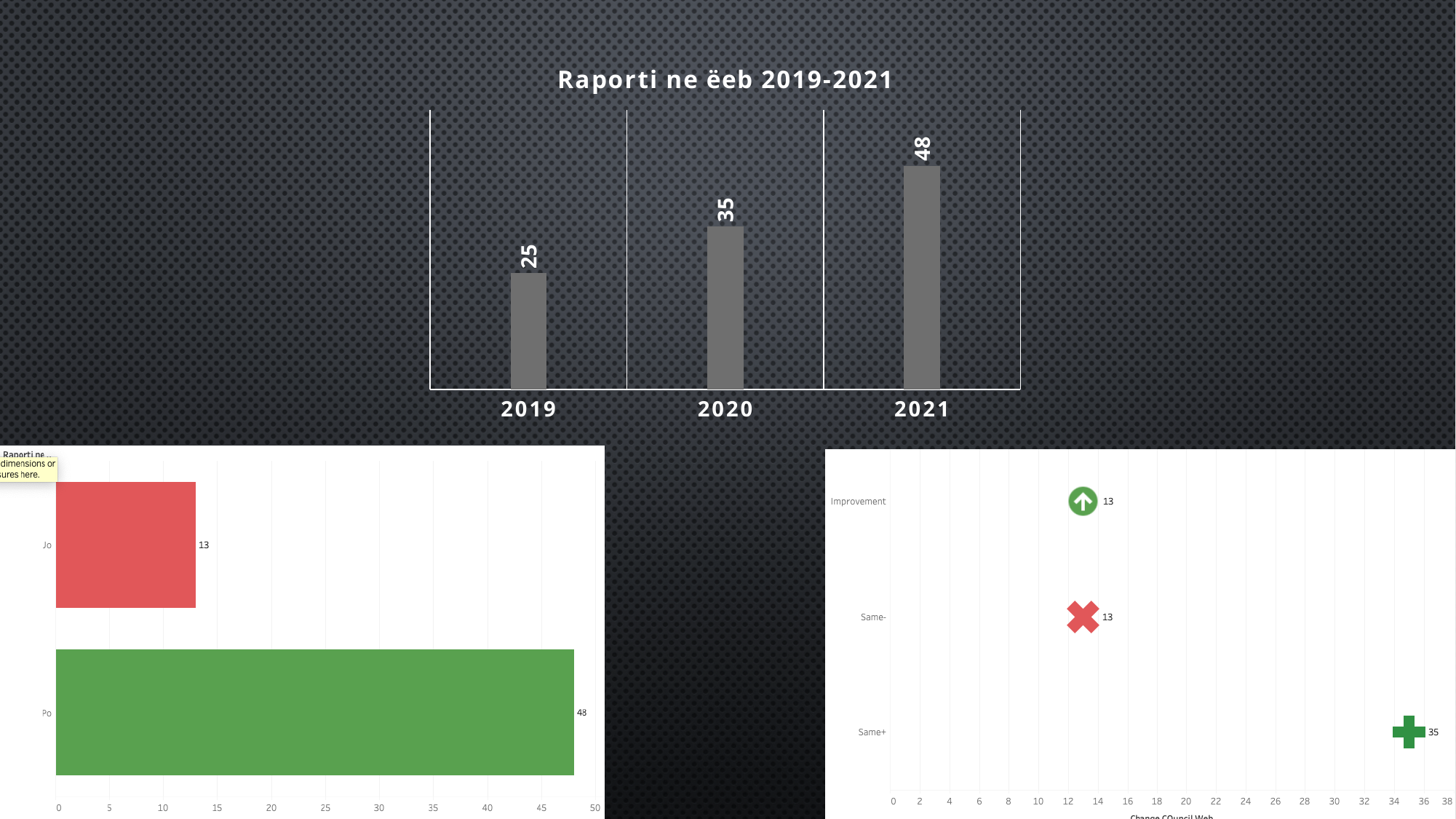
In the bottom-left chart, which is larger, Jo or Po? Po In the bottom-right chart, what is the value for Same+? 35 In the top chart titled "Raporti ne ëeb 2019-2021", do the values rise or fall from 2019 to 2021? rise In the bottom-left chart, what is the difference between the values for Po and Jo? 35 In the top chart titled "Raporti ne ëeb 2019-2021", which year has the lowest value? 2019 In the bottom-right chart, what is the value for Improvement? 13 How many years are shown in the top chart titled "Raporti ne ëeb 2019-2021"? 3 In the top chart titled "Raporti ne ëeb 2019-2021", what is the value for 2020? 35 In the top chart titled "Raporti ne ëeb 2019-2021", what is the difference between the values for 2021 and 2019? 23 What kind of chart is the top chart titled "Raporti ne ëeb 2019-2021"? bar chart In the top chart titled "Raporti ne ëeb 2019-2021", which year has the highest value? 2021 In the bottom-left chart, what is the value for Po? 48